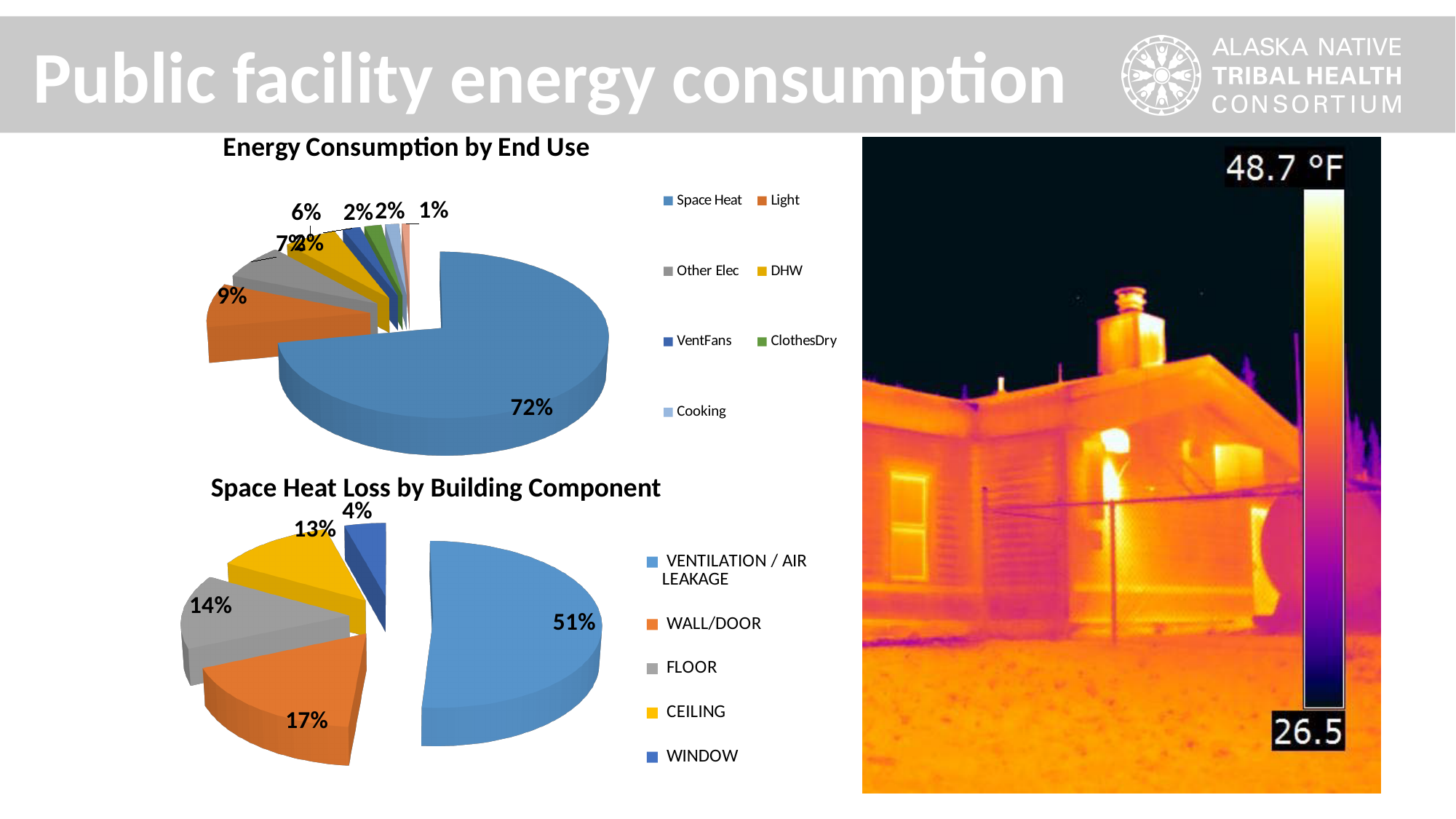
In the 'Energy Consumption by End Use' chart, what percentage is shown for Light? 9% In the 'Space Heat Loss by Building Component' chart, what percentage is shown for CEILING? 13% In the 'Energy Consumption by End Use' chart, which end use has the largest share? Space Heat In the 'Space Heat Loss by Building Component' chart, what share is attributed to VENTILATION / AIR LEAKAGE? 51% In the 'Space Heat Loss by Building Component' chart, which component has the smallest share? WINDOW In the 'Energy Consumption by End Use' chart, what share does Space Heat account for? 72% In the 'Energy Consumption by End Use' chart, what percentage is shown for Other Elec? 7% In the 'Space Heat Loss by Building Component' chart, what percentage is shown for WALL/DOOR? 17% What type of chart is 'Space Heat Loss by Building Component'? Pie chart In the 'Space Heat Loss by Building Component' chart, which is larger, FLOOR or CEILING? FLOOR In the 'Space Heat Loss by Building Component' chart, how many building components are listed in the legend? 5 In the 'Energy Consumption by End Use' chart, what is the difference between the Space Heat share and the Light share? 63%